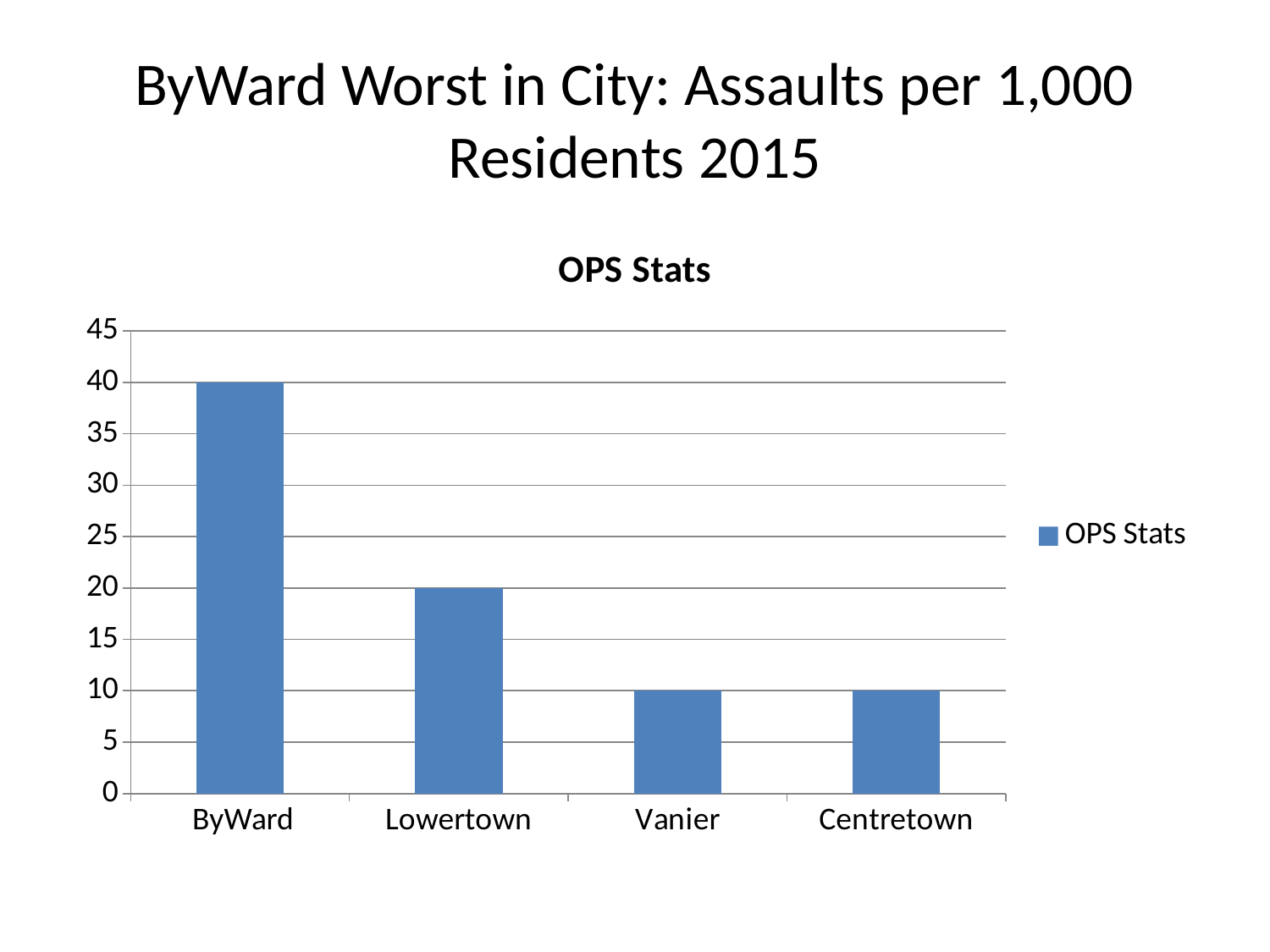
What kind of chart is shown on the slide? bar chart What is the difference between the values for ByWard and Lowertown? 20 Which is larger, the value for ByWard or the value for Centretown? ByWard What is the value for Lowertown? 20 What is the value for Centretown? 10 Which category has the highest value? ByWard What is the value for ByWard? 40 What is the difference between the values for Lowertown and Vanier? 10 How many series does the legend list? 1 What is the value for Vanier? 10 Is the value for Lowertown greater or less than 30? less How many categories are shown on the x axis? 4